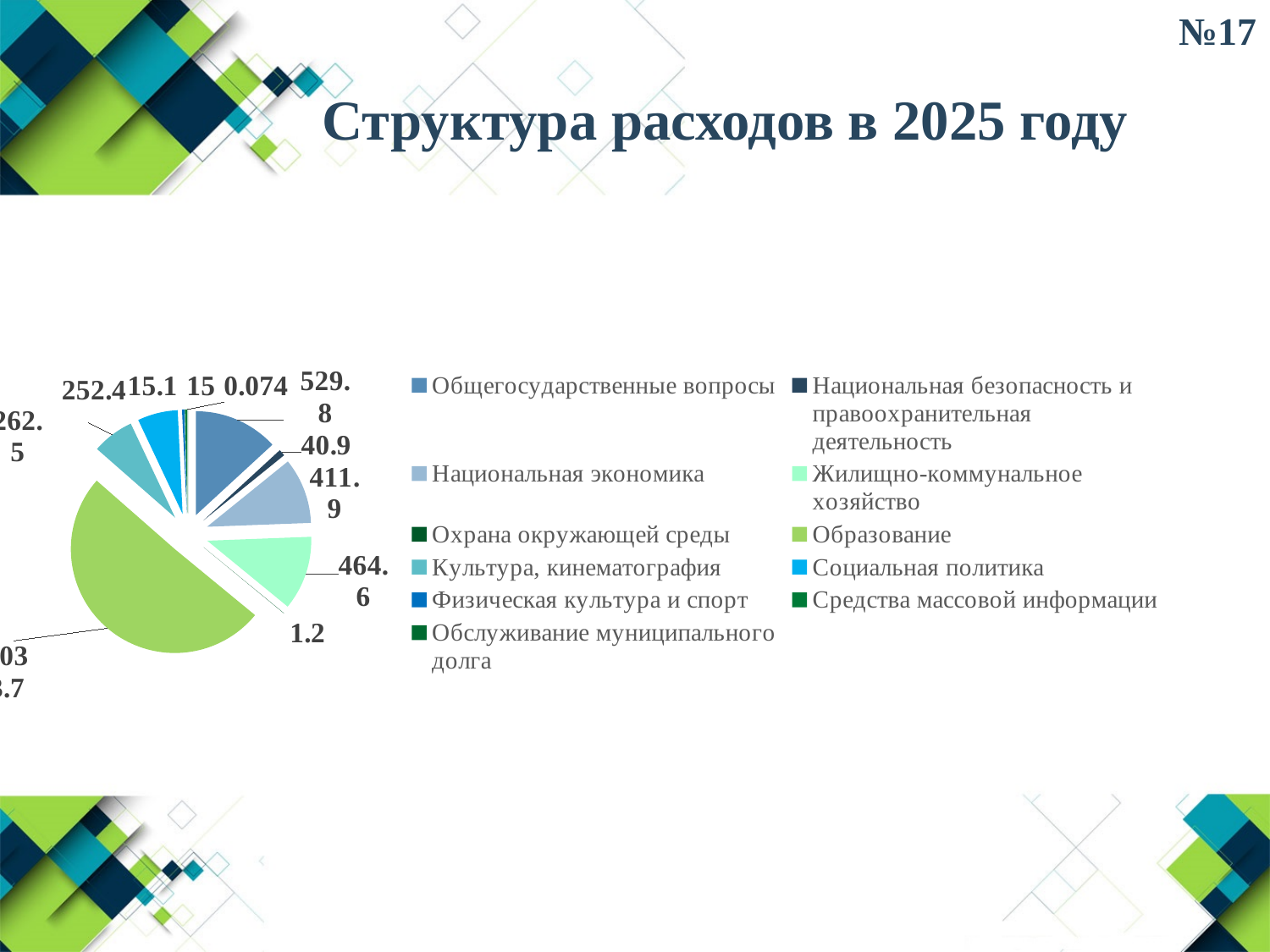
Which category has the smallest value in the pie chart? Обслуживание муниципального долга What is the value shown for Жилищно-коммунальное хозяйство? 464.6 What is the value shown for Культура, кинематография? 262.5 What is the value shown for Общегосударственные вопросы? 529.8 How many categories does the legend list? 11 What kind of chart is shown on the slide? pie chart What is the value shown for Национальная экономика? 411.9 Which is larger: Жилищно-коммунальное хозяйство or Национальная экономика? Жилищно-коммунальное хозяйство What is the value shown for Социальная политика? 252.4 Which category has the largest slice of the pie? Образование What is the difference between the values for Общегосударственные вопросы and Национальная безопасность и правоохранительная деятельность? 488.9 What is the value shown for Национальная безопасность и правоохранительная деятельность? 40.9